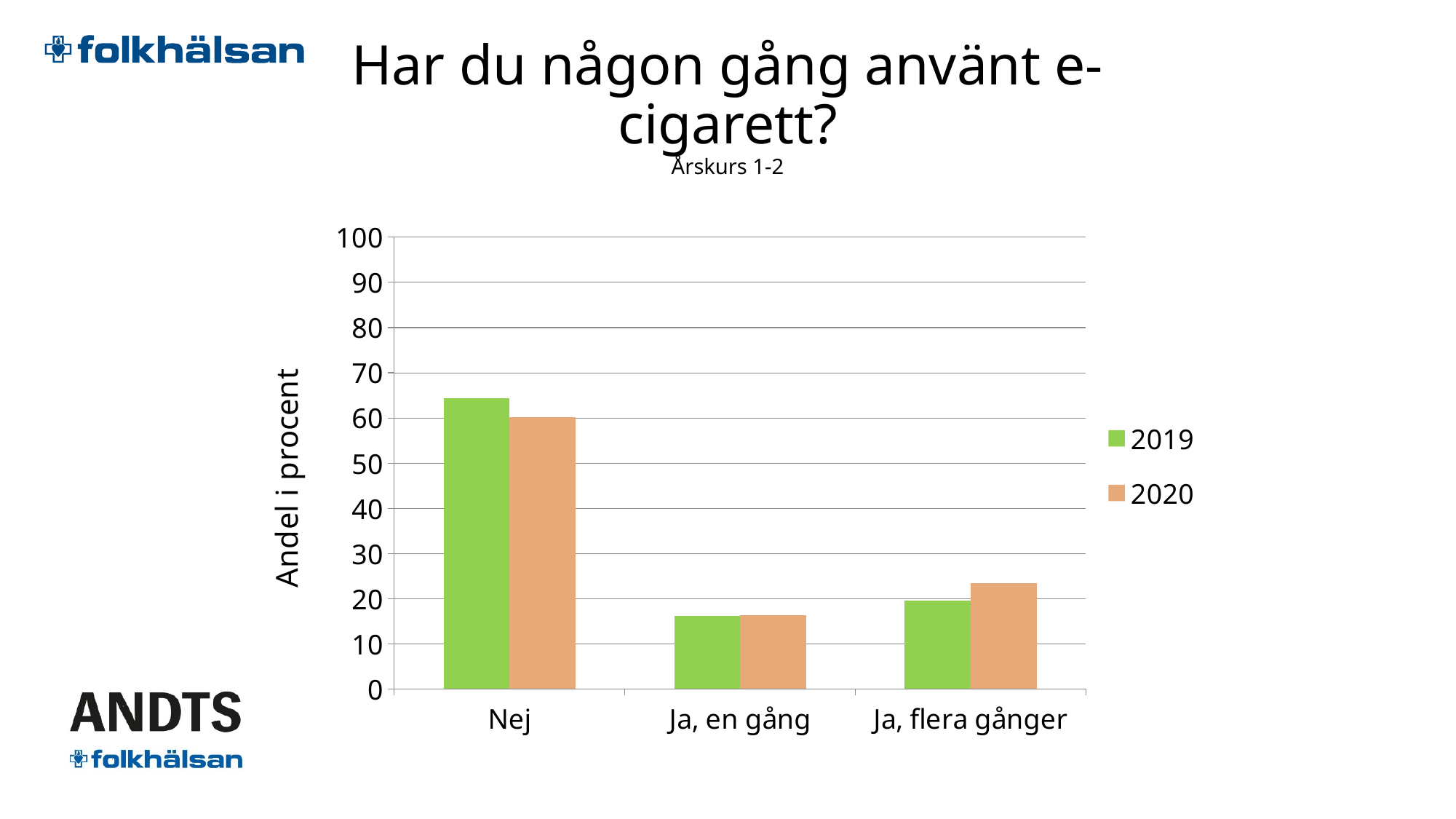
Which category has the highest value for 2019? Nej How many answer categories are shown on the x axis? 3 For the category Nej, which year has the larger value, 2019 or 2020? 2019 What kind of chart is shown on the slide? Bar chart Which category has the lowest value for 2019? Ja, en gång What is the label of the y axis? Andel i procent Which category has the lowest value for 2020? Ja, en gång For the category Ja, flera gånger, which year has the larger value, 2019 or 2020? 2020 Is the 2020 value for Ja, flera gånger greater or less than 20? greater Is the 2019 value for Nej greater or less than 60? greater How many series does the legend list? 2 Is the 2019 value for Ja, en gång greater or less than 20? less